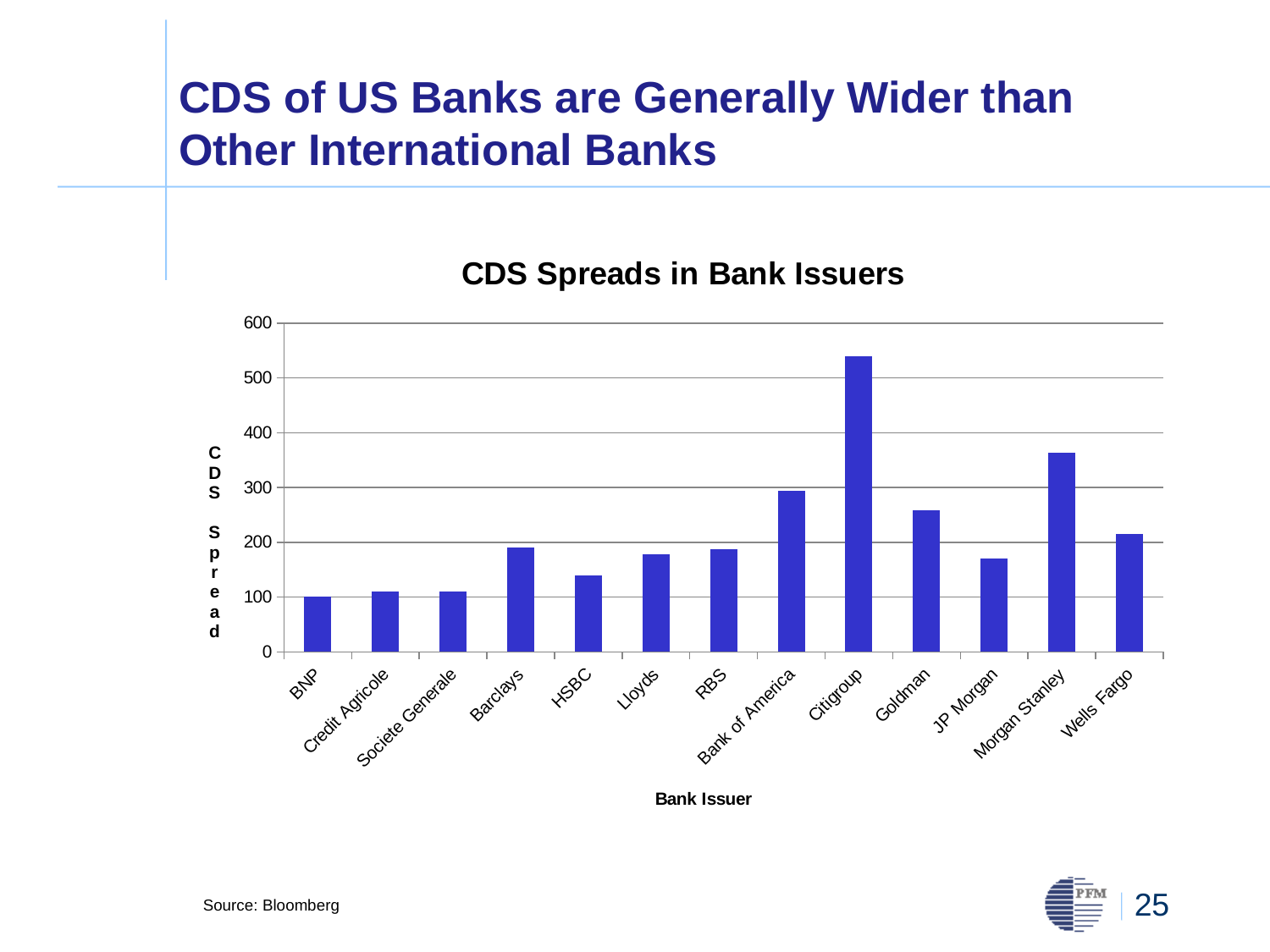
Which has a larger CDS spread, Barclays or HSBC? Barclays Is the CDS spread for Morgan Stanley greater or less than 300? greater Is the CDS spread for JP Morgan greater or less than 200? less What kind of chart is shown on the slide? bar chart Is the CDS spread for Citigroup greater or less than 500? greater Which has a larger CDS spread, Citigroup or Morgan Stanley? Citigroup Which bank issuer has the highest CDS spread? Citigroup What is the title of the chart? CDS Spreads in Bank Issuers How many bank issuers are plotted on the chart? 13 Which has a larger CDS spread, Bank of America or Goldman? Bank of America